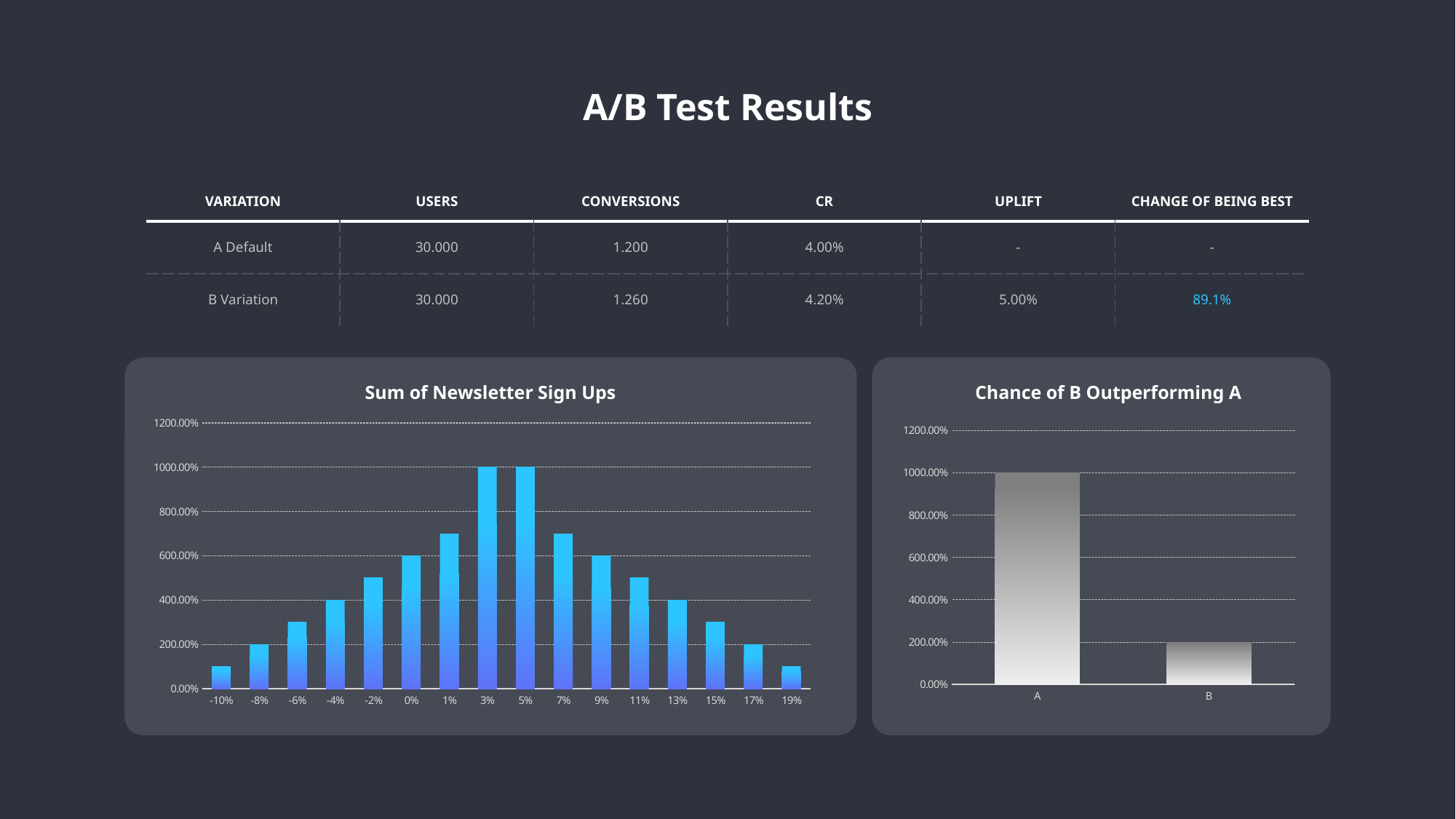
What type of chart is "Sum of Newsletter Sign Ups"? bar chart In the "Sum of Newsletter Sign Ups" chart, what is the value for -8%? 200.00% In the "Sum of Newsletter Sign Ups" chart, is the value for 1% greater or less than 600.00%? greater In the "Sum of Newsletter Sign Ups" chart, what is the value for 0%? 600.00% In the "Sum of Newsletter Sign Ups" chart, do the values rise or fall from -10% to 3%? rise In the "Chance of B Outperforming A" chart, which category has the lowest value? B In the "Chance of B Outperforming A" chart, what is the difference between the values for A and B? 800.00% In the "Chance of B Outperforming A" chart, what is the value for A? 1000.00% In the "Sum of Newsletter Sign Ups" chart, how many categories are shown on the x axis? 16 In the "Sum of Newsletter Sign Ups" chart, which is larger, the value for -2% or the value for 15%? -2% In the "Sum of Newsletter Sign Ups" chart, what is the value for 3%? 1000.00% In the "Sum of Newsletter Sign Ups" chart, is the value for -6% greater or less than 400.00%? less